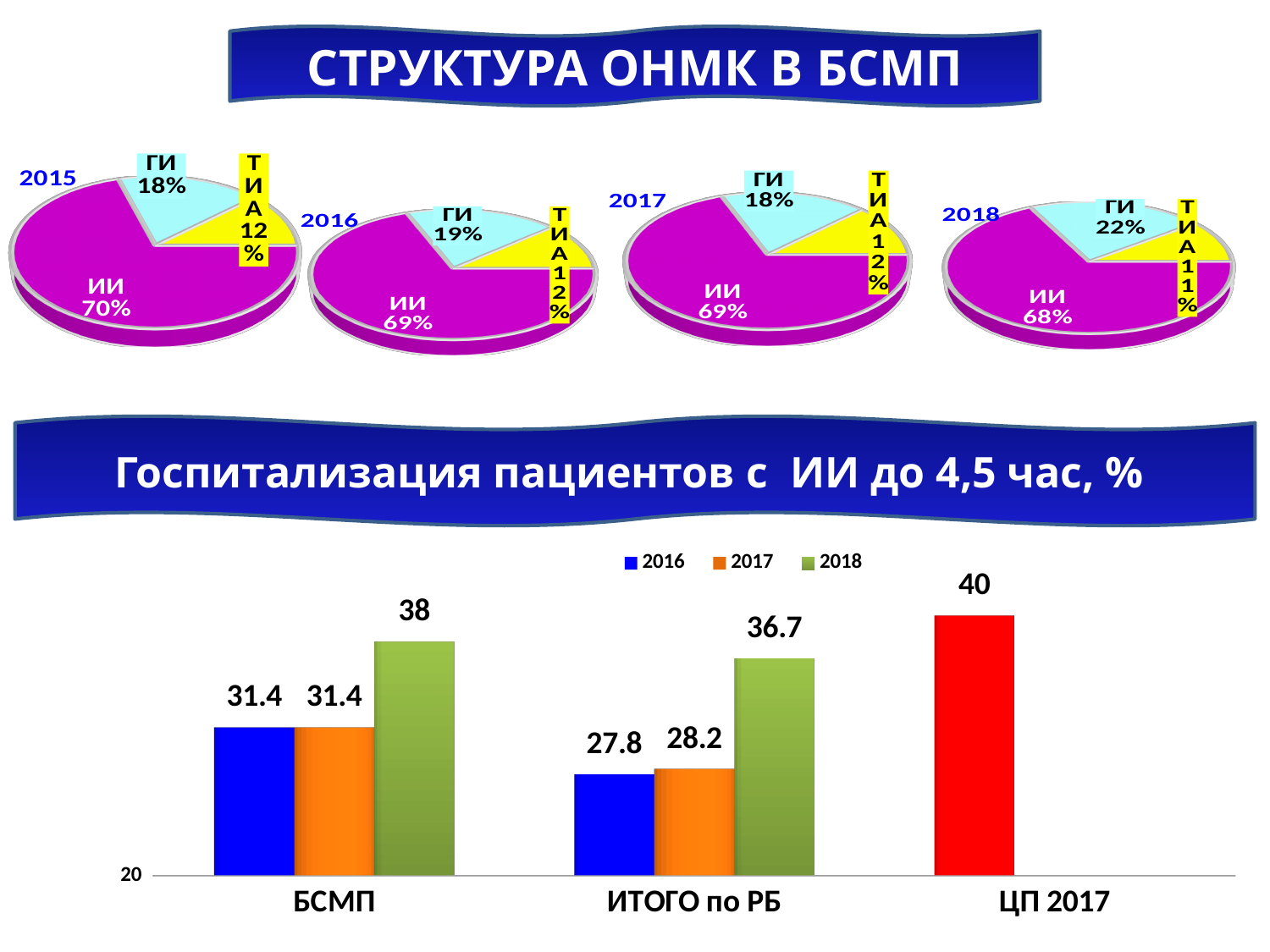
In the bar chart 'Госпитализация пациентов с ИИ до 4,5 час, %', which is larger: БСМП in 2018 or ИТОГО по РБ in 2018? БСМП in 2018 In the 2015 pie chart, what share does ИИ have? 70% In the 2018 pie chart, what is the difference between the ИИ share and the ГИ share? 46% In the 2016 pie chart, which category has the smallest slice? ТИА In the 2017 pie chart, which category has the largest slice? ИИ In the bar chart 'Госпитализация пациентов с ИИ до 4,5 час, %', what is the value for БСМП in 2018? 38 How many pie charts are shown in the top section of the slide? 4 How many series does the legend of the bar chart 'Госпитализация пациентов с ИИ до 4,5 час, %' list? 3 What type of chart is 'Госпитализация пациентов с ИИ до 4,5 час, %'? Bar chart In the 2018 pie chart, what share does ГИ have? 22% In the bar chart 'Госпитализация пациентов с ИИ до 4,5 час, %', what is the difference between the 2018 and 2017 values for ИТОГО по РБ? 8.5 In the bar chart 'Госпитализация пациентов с ИИ до 4,5 час, %', what is the value for ИТОГО по РБ in 2016? 27.8